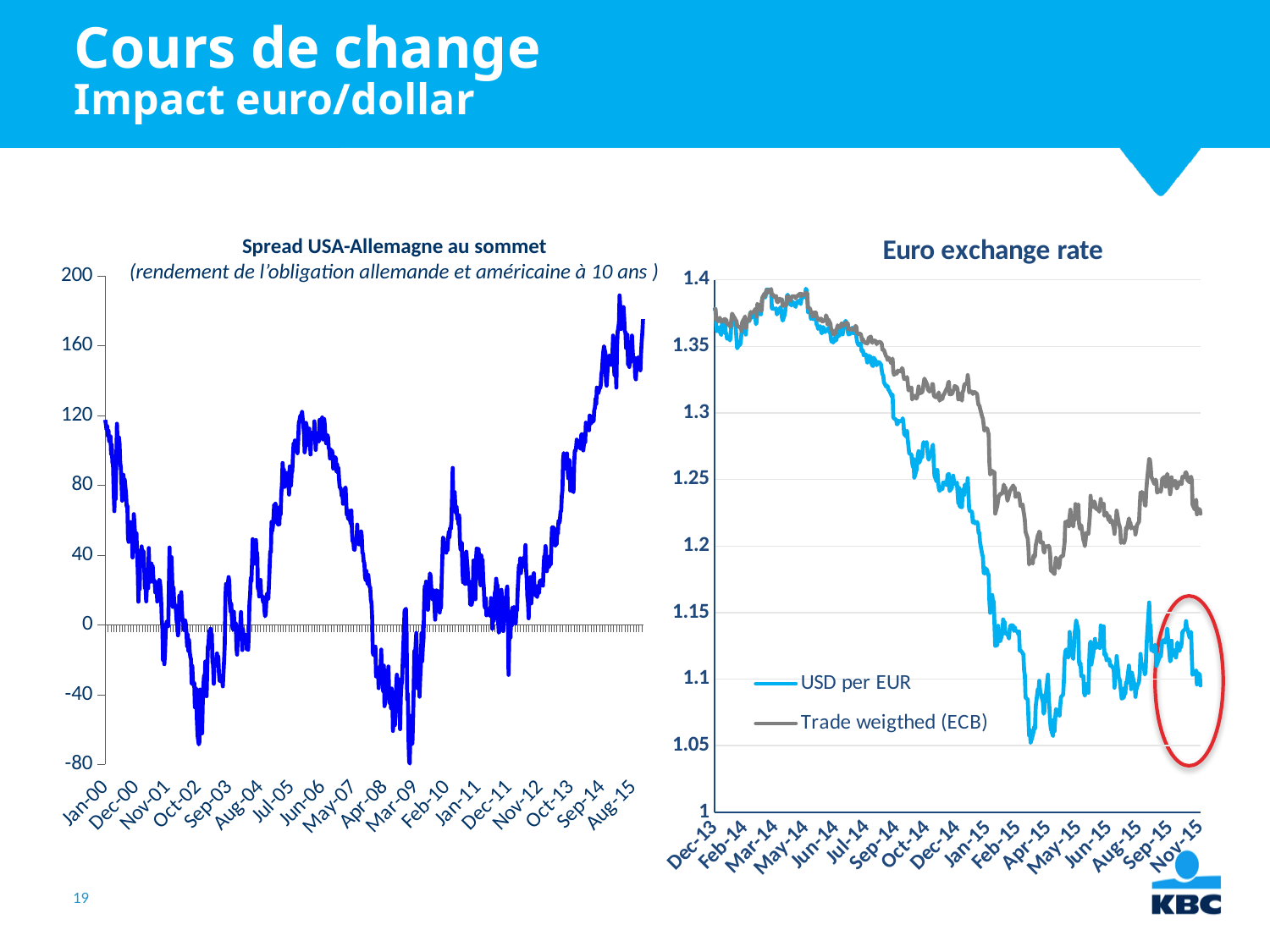
What kind of chart is the 'Euro exchange rate' chart? line chart In the 'Euro exchange rate' chart, what are the two series named in the legend? USD per EUR and Trade weigthed (ECB) What kind of chart is the 'Spread USA-Allemagne au sommet' chart? line chart In the 'Spread USA-Allemagne au sommet' chart, is the value at Jan-00 greater or less than 80? greater In the 'Euro exchange rate' chart, is the USD per EUR value at Nov-15 greater or less than 1.15? less In the 'Spread USA-Allemagne au sommet' chart, is the lowest value of the series, around Mar-09, greater or less than -40? less In the 'Euro exchange rate' chart, does the USD per EUR series rise or fall overall from Dec-13 to Nov-15? fall How many series does the legend of the 'Euro exchange rate' chart list? 2 In the 'Euro exchange rate' chart, at Nov-15, which series is higher: USD per EUR or Trade weigthed (ECB)? Trade weigthed (ECB)